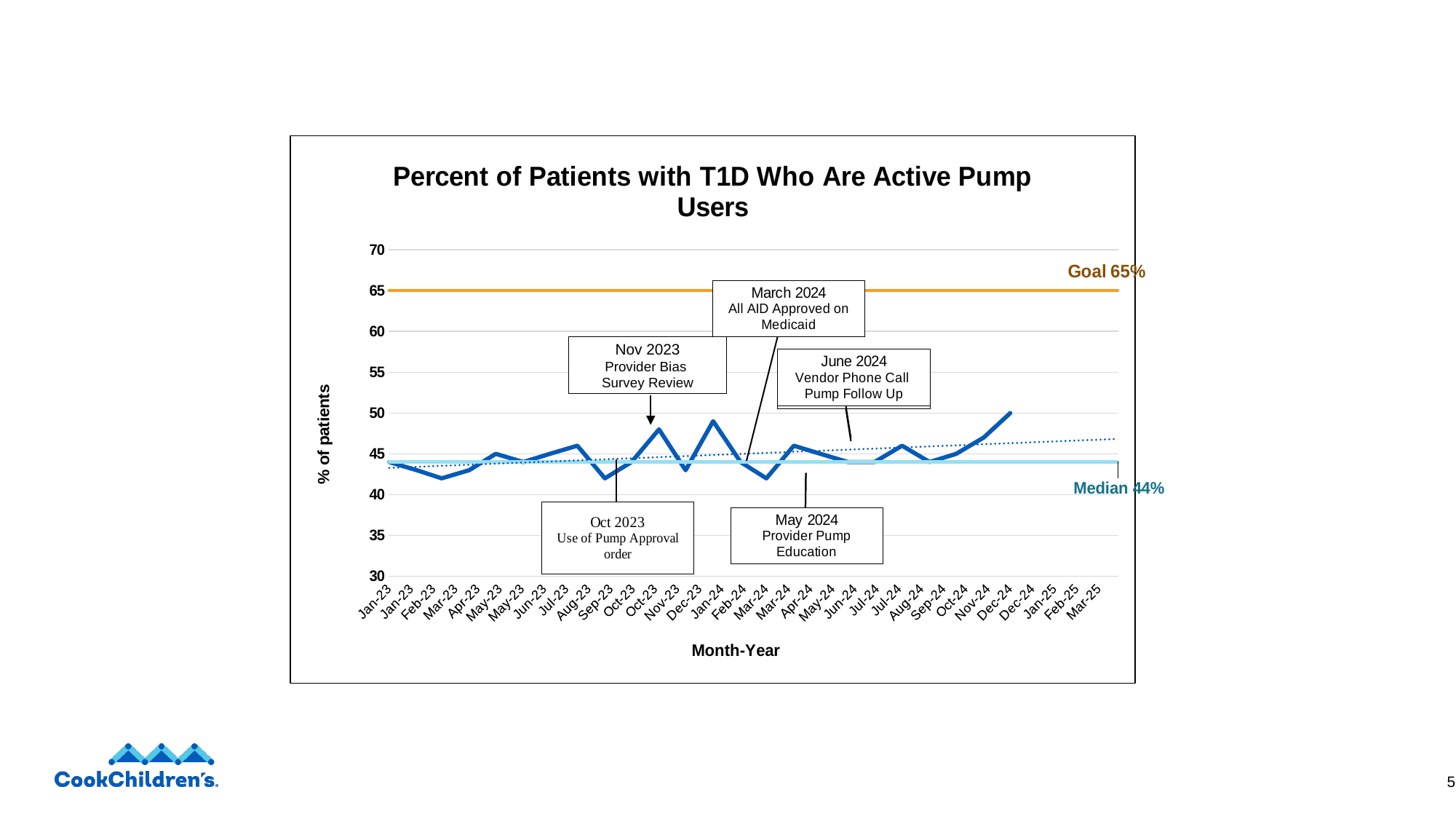
Does the dotted trend line rise or fall from left to right? rise What intervention is annotated for Nov 2023? Provider Bias Survey Review What is the goal value marked on the chart? 65% Is the value for Jan-24 greater or less than 55? less Does the plotted line ever reach the goal line of 65%? No What is the median value marked on the chart? 44% Is the value for Dec-24 greater or less than 45? greater Which is larger, the goal value or the median value? Goal 65% What is the difference between the goal value and the median value? 21 percentage points What is the title of the chart? Percent of Patients with T1D Who Are Active Pump Users What kind of chart is shown on the slide? line chart